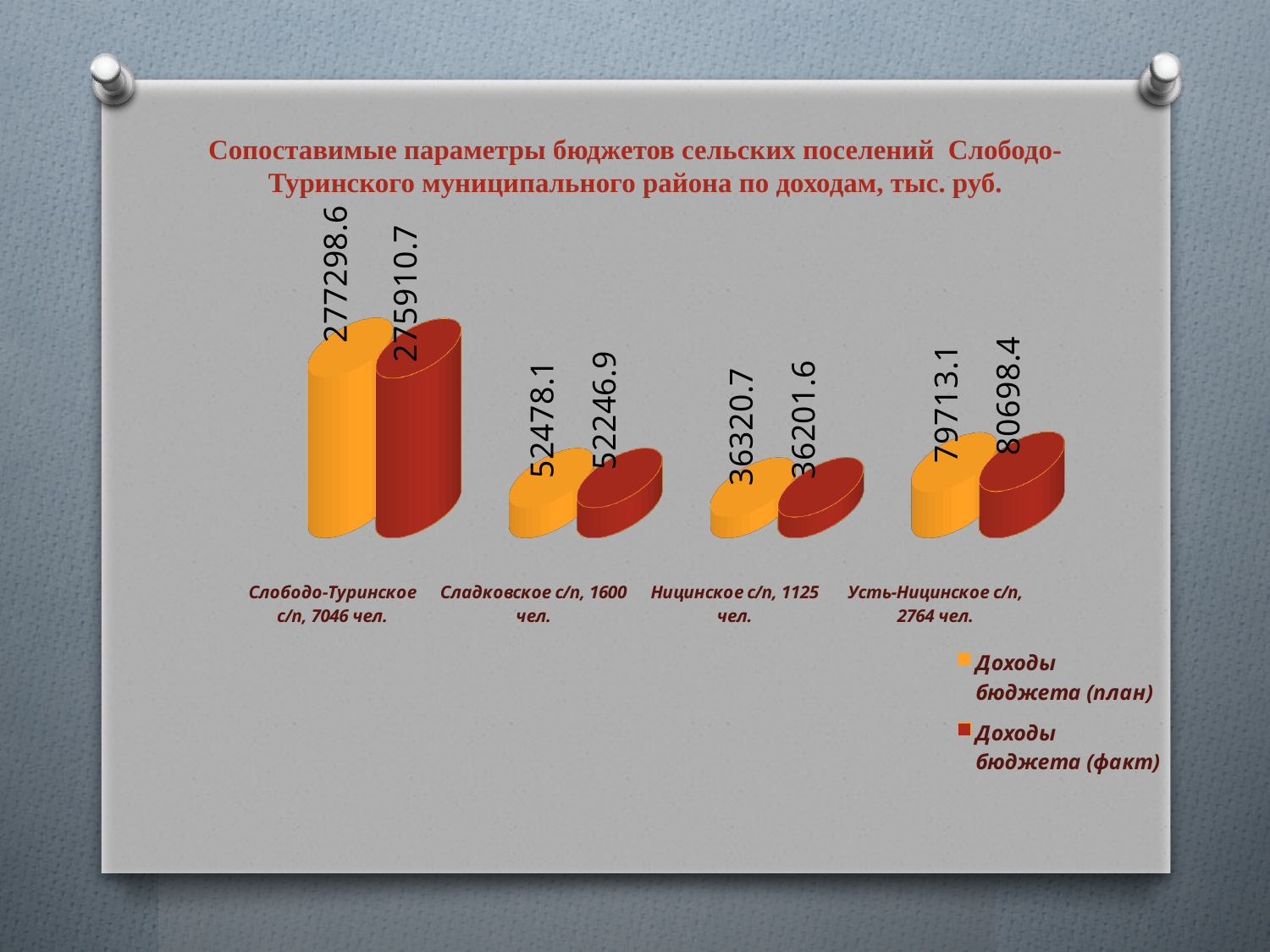
What is the actual budget income (Доходы бюджета (факт)) for Сладковское с/п? 52246.9 What is the difference between the planned and actual budget income for Слободо-Туринское с/п? 1387.9 Which colour represents the series Доходы бюджета (факт) in the legend? Red For Усть-Ницинское с/п, which is larger: the planned (план) or the actual (факт) budget income? Actual (факт) Which settlement has the lowest planned budget income (план)? Ницинское с/п How many series does the legend list? 2 How many settlements (categories) are shown on the x axis? 4 Which settlement has the highest actual budget income (факт)? Слободо-Туринское с/п What type of chart is shown on the slide? Bar chart What is the planned budget income (Доходы бюджета (план)) for Слободо-Туринское с/п? 277298.6 What is the planned budget income (план) for Ницинское с/п? 36320.7 What is the actual budget income (факт) for Усть-Ницинское с/п? 80698.4